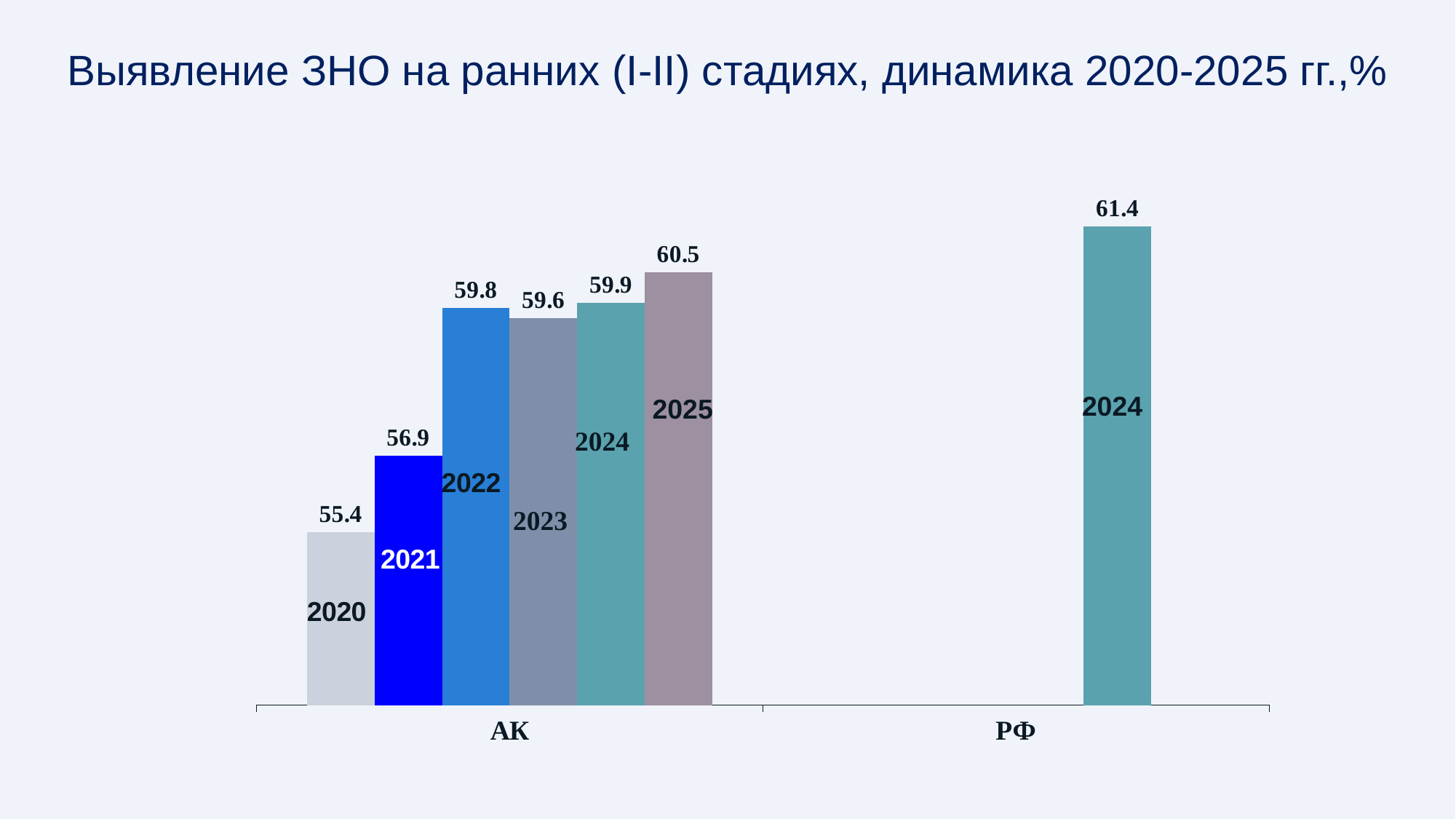
What is the value for 2025 in the АК group? 60.5 What is the difference between the РФ 2024 value and the АК 2024 value? 1.5 What is the difference between the 2025 and 2020 values in the АК group? 5.1 What is the value for 2024 in the РФ group? 61.4 What is the title of the chart? Выявление ЗНО на ранних (I-II) стадиях, динамика 2020-2025 гг.,% What type of chart is shown on the slide? bar chart How many category groups are shown on the x axis? 2 What is the value for 2022 in the АК group? 59.8 Which year has the lowest value in the АК group? 2020 Which is larger: the 2024 value for АК or the 2024 value for РФ? РФ What is the value for 2020 in the АК group? 55.4 Which year has the highest value in the АК group? 2025